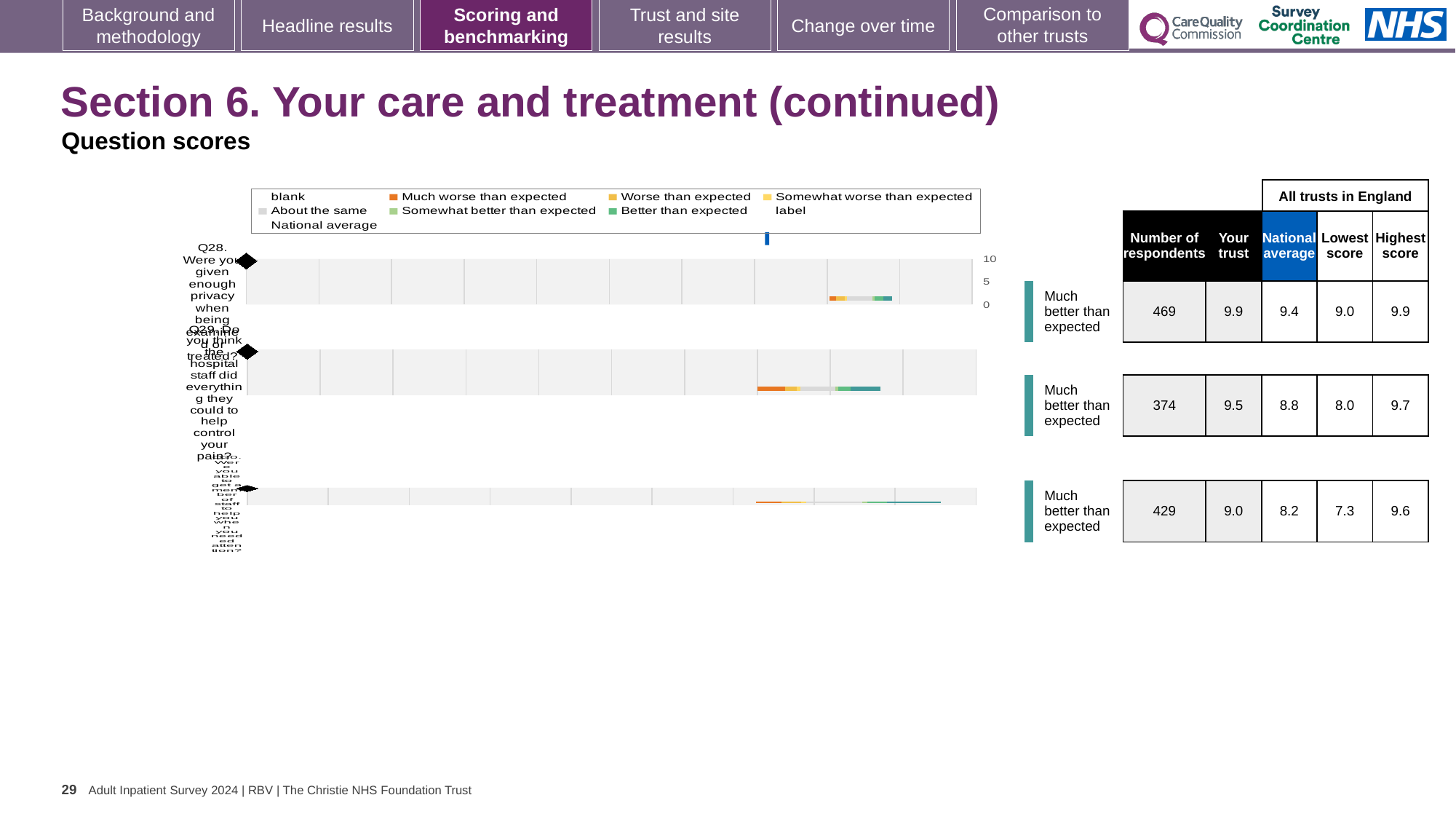
What is the national average score for Q29 (hospital staff did everything to help control pain)? 8.8 Which question has the lowest 'Lowest score' across all trusts in England? Q30 How many respondents answered Q30 (able to get a member of staff to help when needed)? 429 By how much does the trust's score for Q28 exceed the national average? 0.5 What colour represents 'Much worse than expected' in the legend? Orange What kind of chart is used to show the question scores? Bar chart For Q29, which is larger: the trust's score or the national average? Your trust Which question has the highest 'Your trust' score? Q28 What is the 'Your trust' score for Q28 (privacy when being examined or treated)? 9.9 What is the highest score among all trusts in England for Q29? 9.7 What benchmark category is shown for Q28? Much better than expected How many questions are shown on the chart? 3